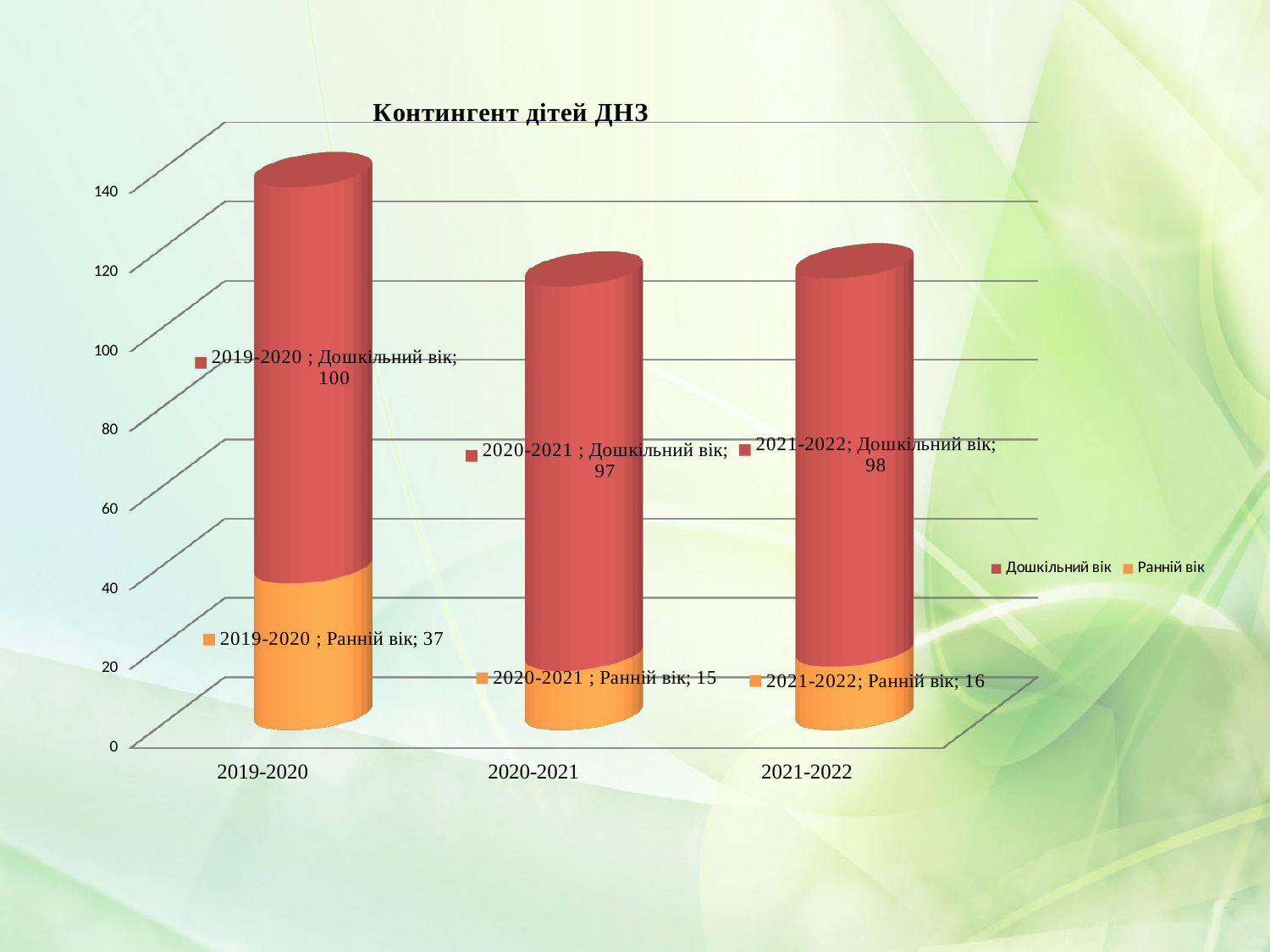
Which year has the lowest value for Дошкільний вік? 2020-2021 What is the title of the chart? Контингент дітей ДНЗ Which year has the highest value for Ранній вік? 2019-2020 What is the total of the stacked bar for 2021-2022? 114 What is the total of the stacked bar for 2019-2020? 137 How many years are shown on the x axis? 3 What is the value for Дошкільний вік in 2020-2021? 97 What is the value for Ранній вік in 2021-2022? 16 What is the value for Дошкільний вік in 2019-2020? 100 How many series does the legend list? 2 What is the difference between the Ранній вік values for 2019-2020 and 2020-2021? 22 What is the value for Ранній вік in 2020-2021? 15